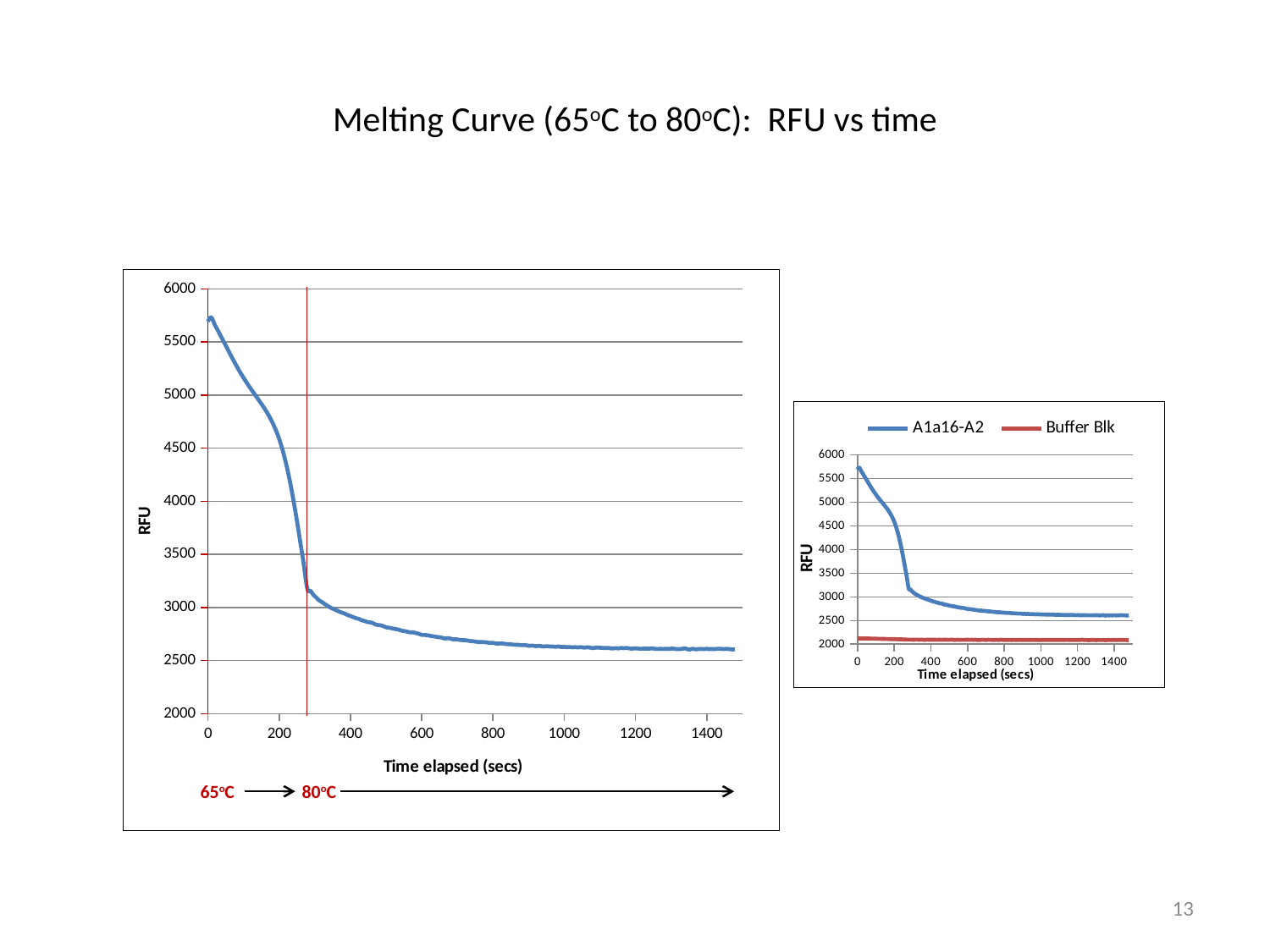
What are the two series names listed in the legend of the small chart on the right? A1a16-A2 and Buffer Blk In the large chart on the left, is the RFU value at 1400 seconds greater or less than 2500? greater What is the title of the x axis of the large chart on the left? Time elapsed (secs) In the large chart on the left, is the RFU value at 1000 seconds greater or less than 3000? less In the large chart on the left, is the RFU value at time 0 greater or less than 5500? greater In the large chart on the left, do the RFU values rise or fall as time elapsed increases? Fall In the small chart on the right, does the A1a16-A2 series rise or fall over time? Fall How many series does the legend of the small chart on the right list? 2 In the small chart on the right, which series has the higher RFU value at time 0, A1a16-A2 or Buffer Blk? A1a16-A2 What kind of chart is the large chart on the left of the slide? Line chart